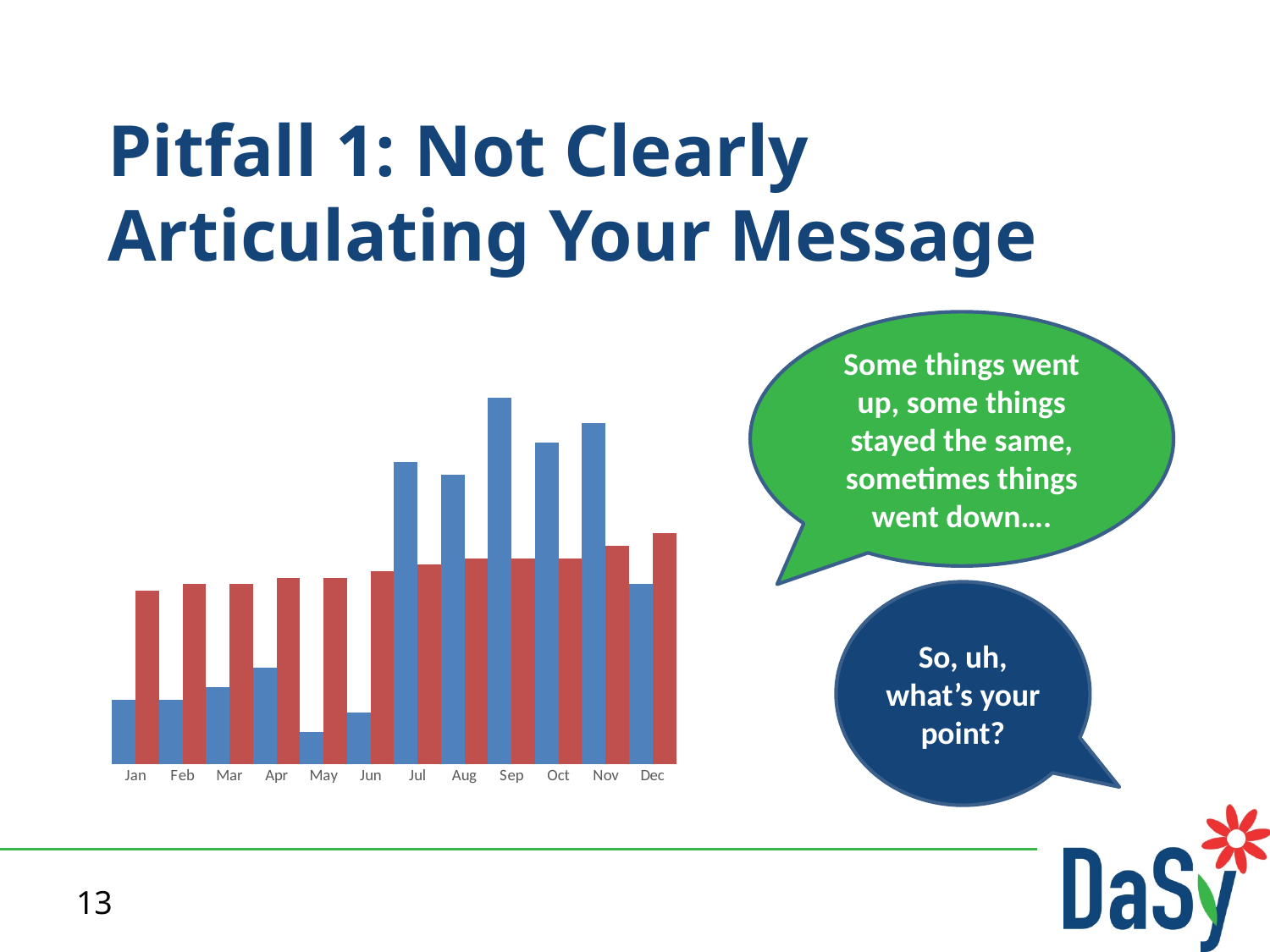
In Jul, which bar is taller, the blue one or the red one? Blue Which month has the shortest blue bar? May What kind of chart is shown on the slide? Bar chart In Dec, which bar is taller, the blue one or the red one? Red Do the red bars generally rise or fall from Jan to Dec? Rise How many months are shown along the x axis of the chart? 12 In Jan, which bar is taller, the blue one or the red one? Red Which month has the tallest blue bar? Sep Does the chart include a legend identifying the bar colours? No Which month has the tallest red bar? Dec What two colours are used for the bars in the chart? Blue and red